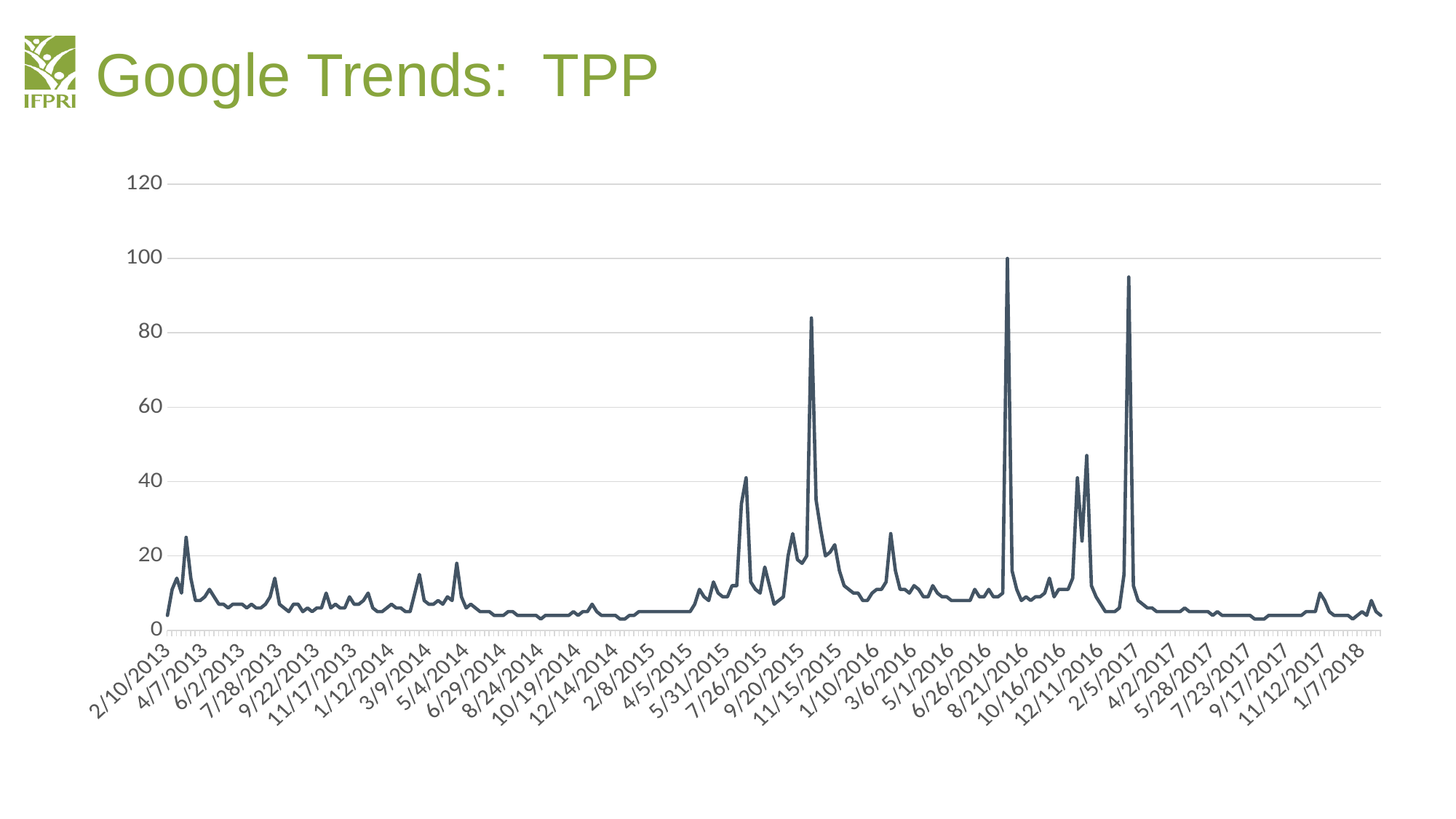
What is the highest value the line reaches? 100 What is the maximum value shown on the vertical axis? 120 Is the value at 2/10/2013 greater or less than 20? less In which year does the line reach its highest value? 2016 Which is higher: the peak just before 8/21/2016 or the peak near 11/15/2015? the peak just before 8/21/2016 What kind of chart is shown on the slide? line chart Is the peak near 7/26/2015 greater or less than 60? less Do the values generally rise or fall between 2/8/2015 and 7/26/2015? rise What is the title of the slide's chart? Google Trends: TPP Is the peak near 11/15/2015 greater or less than 60? greater